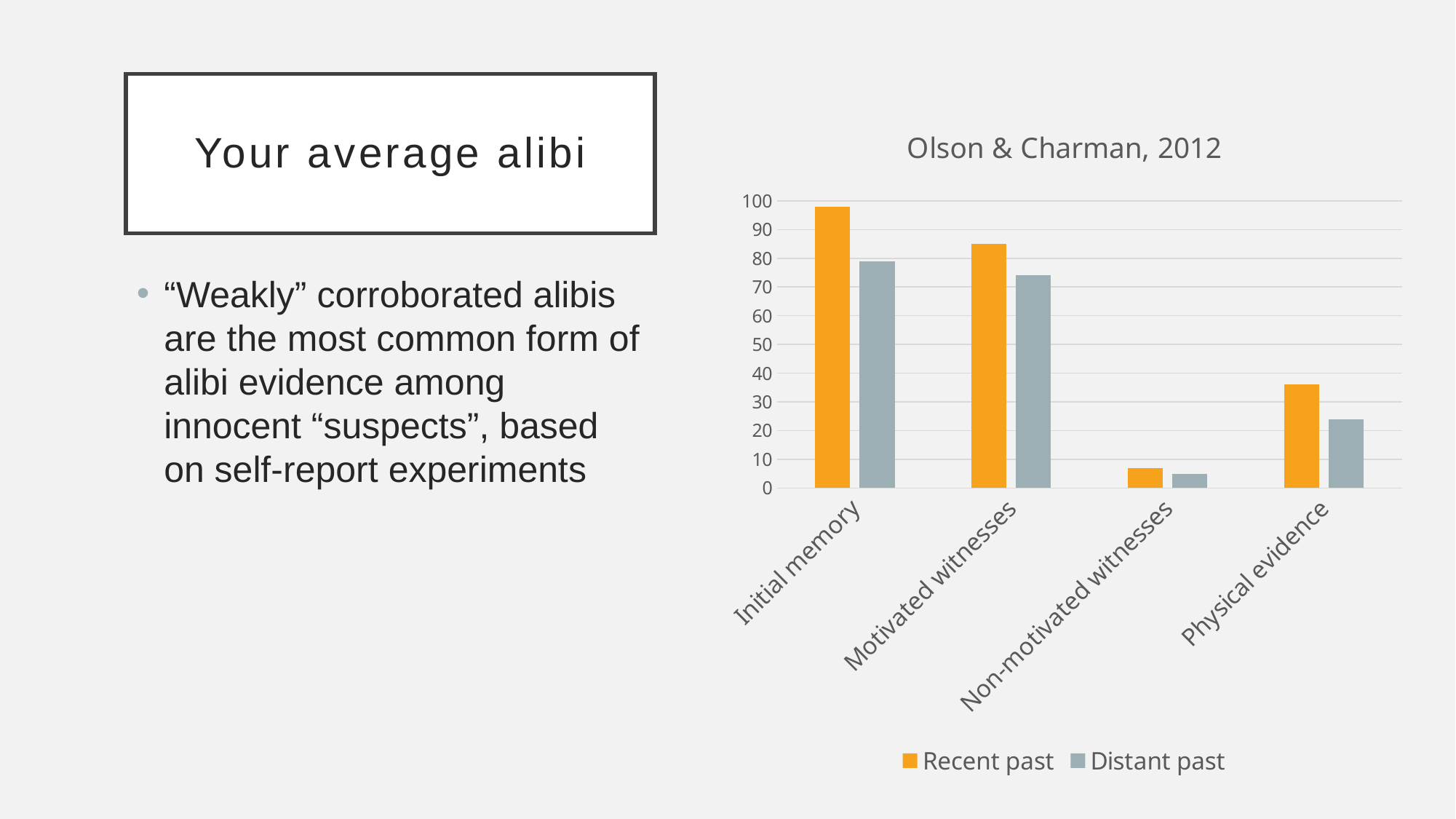
Is the Recent past value for Initial memory greater or less than 90? greater Which category has the lowest Distant past value? Non-motivated witnesses Is the Distant past value for Motivated witnesses greater or less than 60? greater What is the title of the chart? Olson & Charman, 2012 For Initial memory, which is larger: Recent past or Distant past? Recent past What type of chart is shown on the slide? Bar chart Is the Distant past value for Physical evidence greater or less than 30? less How many series does the chart legend list? 2 How many categories are shown on the x axis of the chart? 4 Which colour represents the Recent past series in the chart? Orange Which category has the highest Recent past value? Initial memory